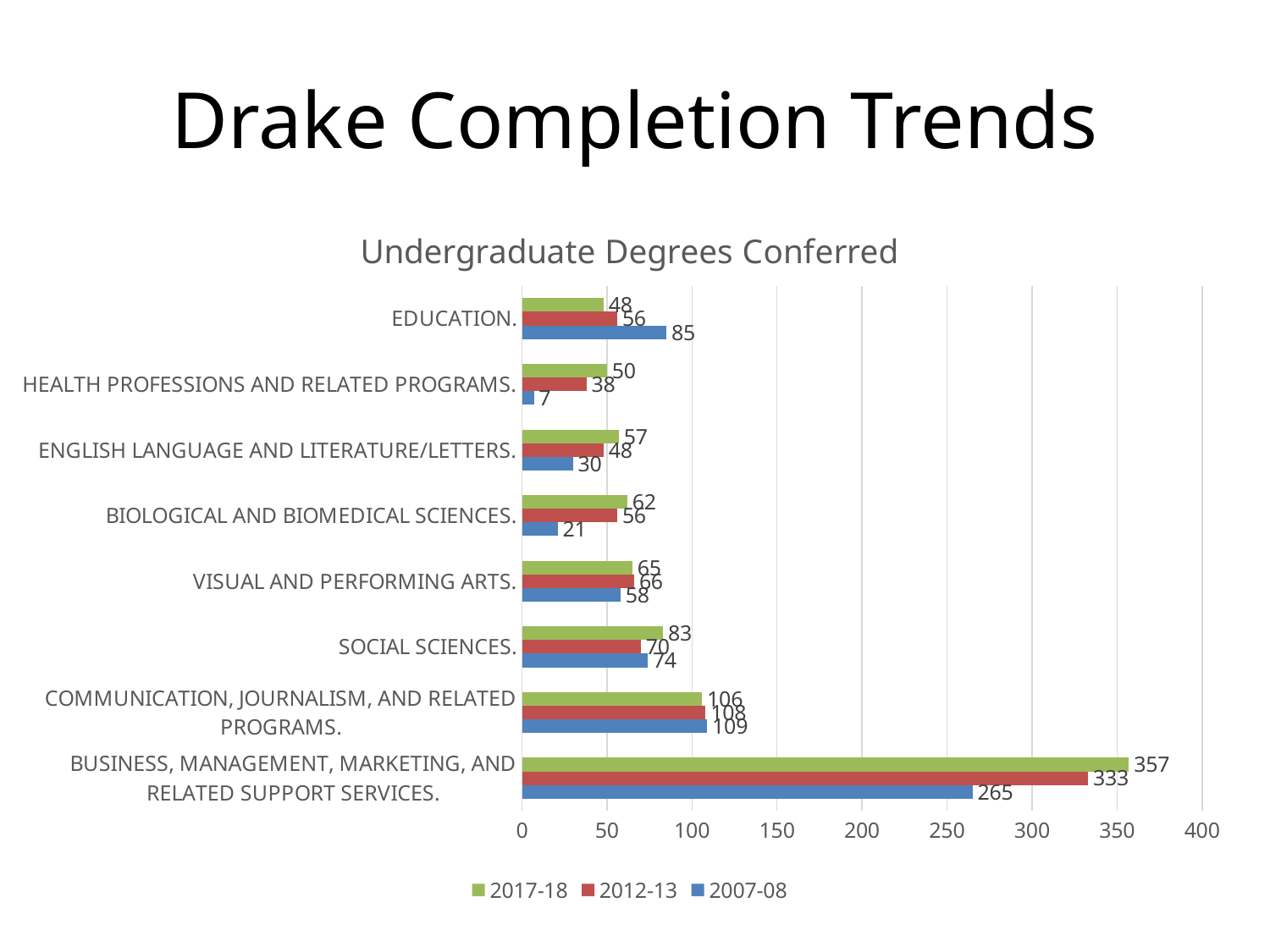
What is the difference between the 2017-18 and 2007-08 values for Business, Management, Marketing, and Related Support Services? 92 Which category has the lowest value in 2007-08? Health Professions and Related Programs What is the value for Health Professions and Related Programs in 2012-13? 38 Is the 2012-13 value for Business, Management, Marketing, and Related Support Services greater or less than 300? greater How many series does the legend list? 3 What is the value for Education in 2007-08? 85 What kind of chart is shown on the slide? Bar chart What is the value for Business, Management, Marketing, and Related Support Services in 2017-18? 357 Which is larger for Biological and Biomedical Sciences: the 2017-18 value or the 2007-08 value? 2017-18 What is the title of the chart? Undergraduate Degrees Conferred Which category has the highest value in 2007-08? Business, Management, Marketing, and Related Support Services How many categories are shown on the chart? 8